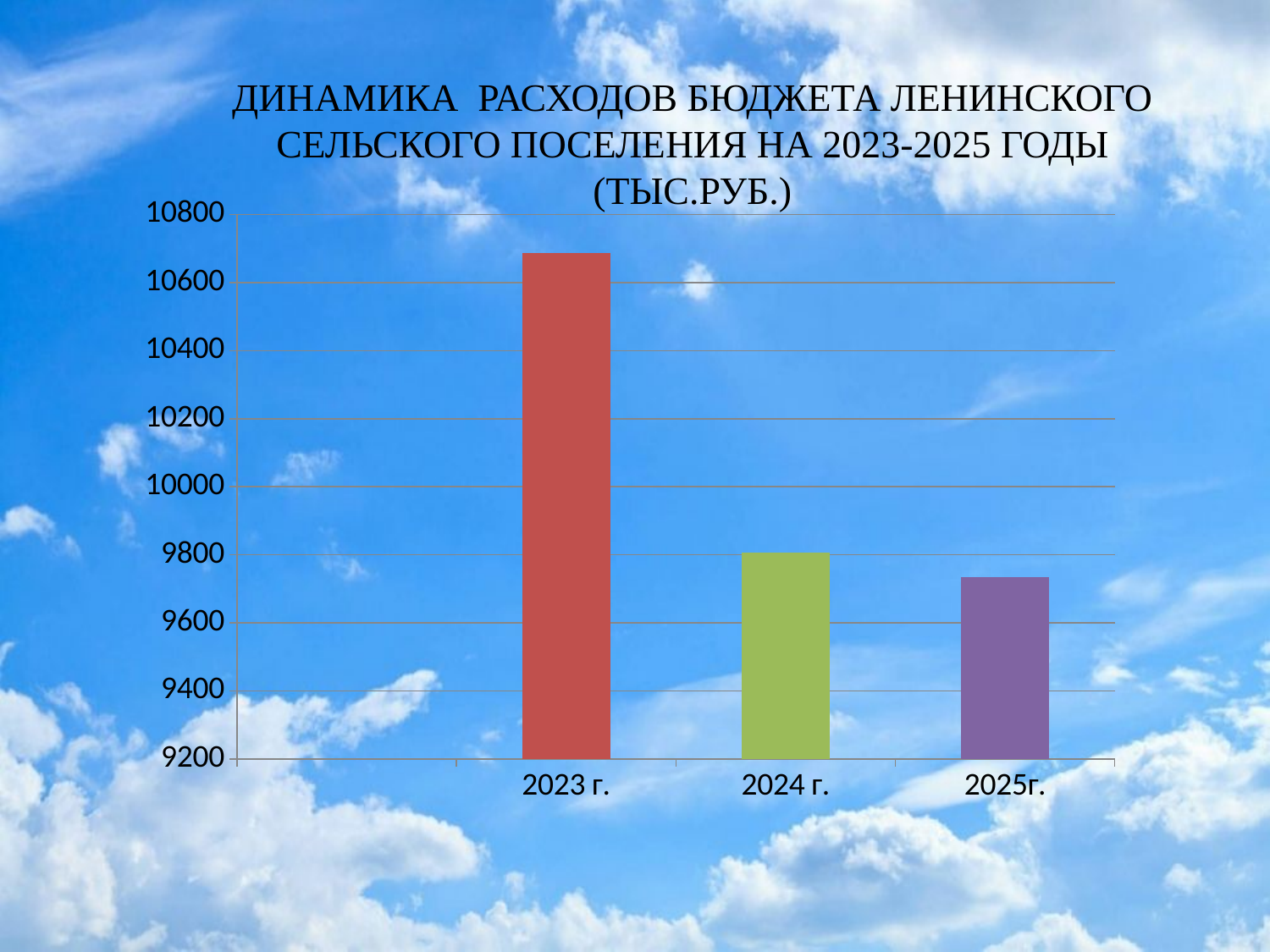
Which year has the lowest budget expenditure on the chart? 2025г. How many years (categories) are plotted on the chart? 3 Is the value for 2023 г. greater or less than 10600? greater Do the values rise or fall from 2023 г. to 2025г.? fall What unit is given in the chart title for the values? ТЫС.РУБ. Which year has the highest budget expenditure on the chart? 2023 г. Is the value for 2024 г. greater or less than 10000? less Is the value for 2025г. greater or less than 9600? greater Which is larger, the value for 2023 г. or the value for 2024 г.? 2023 г. What colour is the bar for 2023 г.? red What kind of chart is shown on the slide? bar chart